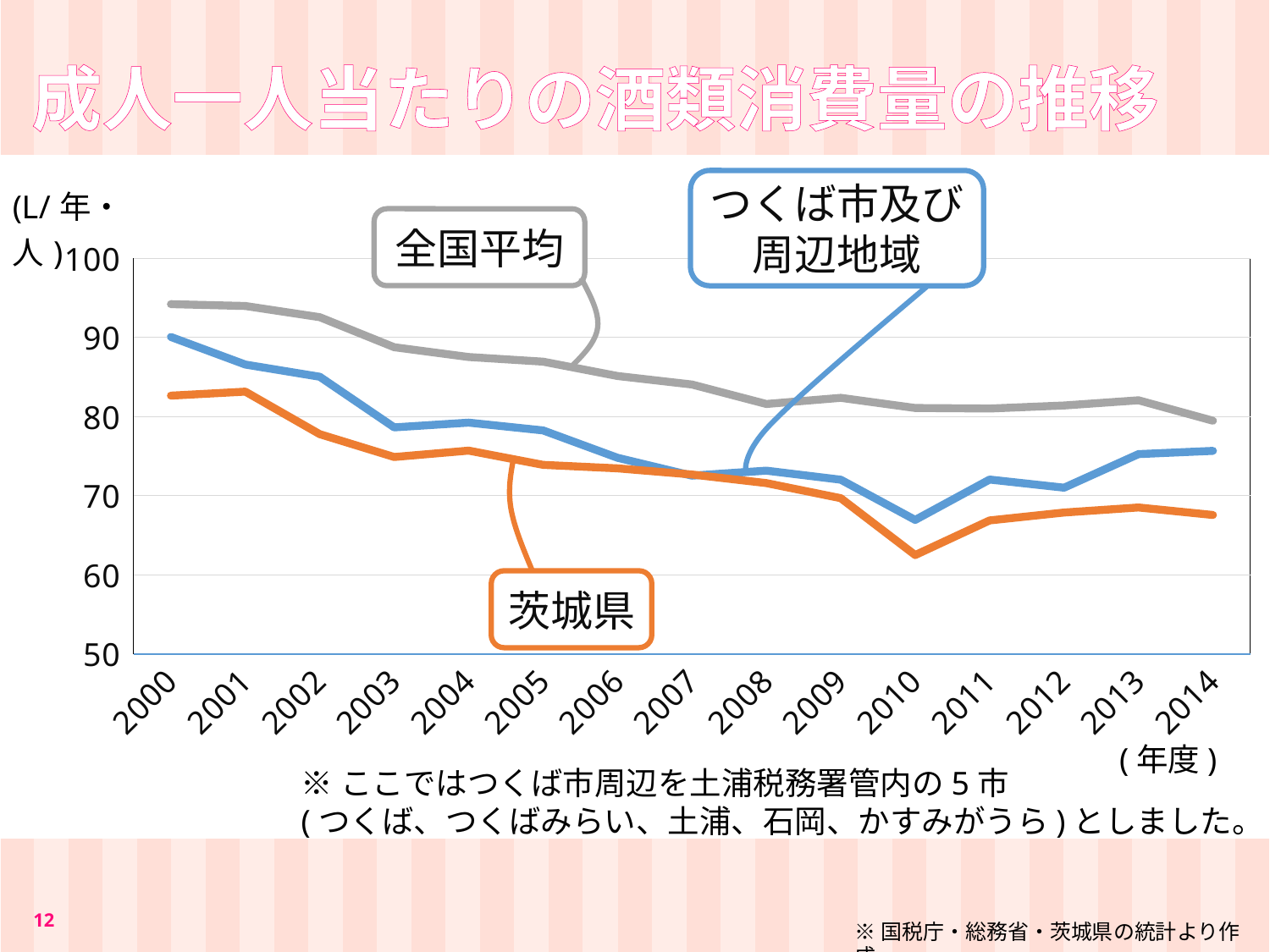
In which year does 茨城県 reach its lowest value? 2010 Is the value for 茨城県 in 2000 greater or less than 80? greater Which series has the highest value in 2014? 全国平均 Does the 全国平均 line generally rise or fall from 2000 to 2014? fall How many series are plotted in the chart? 3 What unit is shown on the y axis of the chart? L/年・人 What is the title of the chart on the slide? 成人一人当たりの酒類消費量の推移 What kind of chart is shown on the slide? line chart In 2010, which is higher, つくば市及び周辺地域 or 茨城県? つくば市及び周辺地域 How many years (data points) are plotted along the x axis? 15 Is the value for 茨城県 in 2010 greater or less than 70? less Is the value for 全国平均 in 2000 greater or less than 90? greater